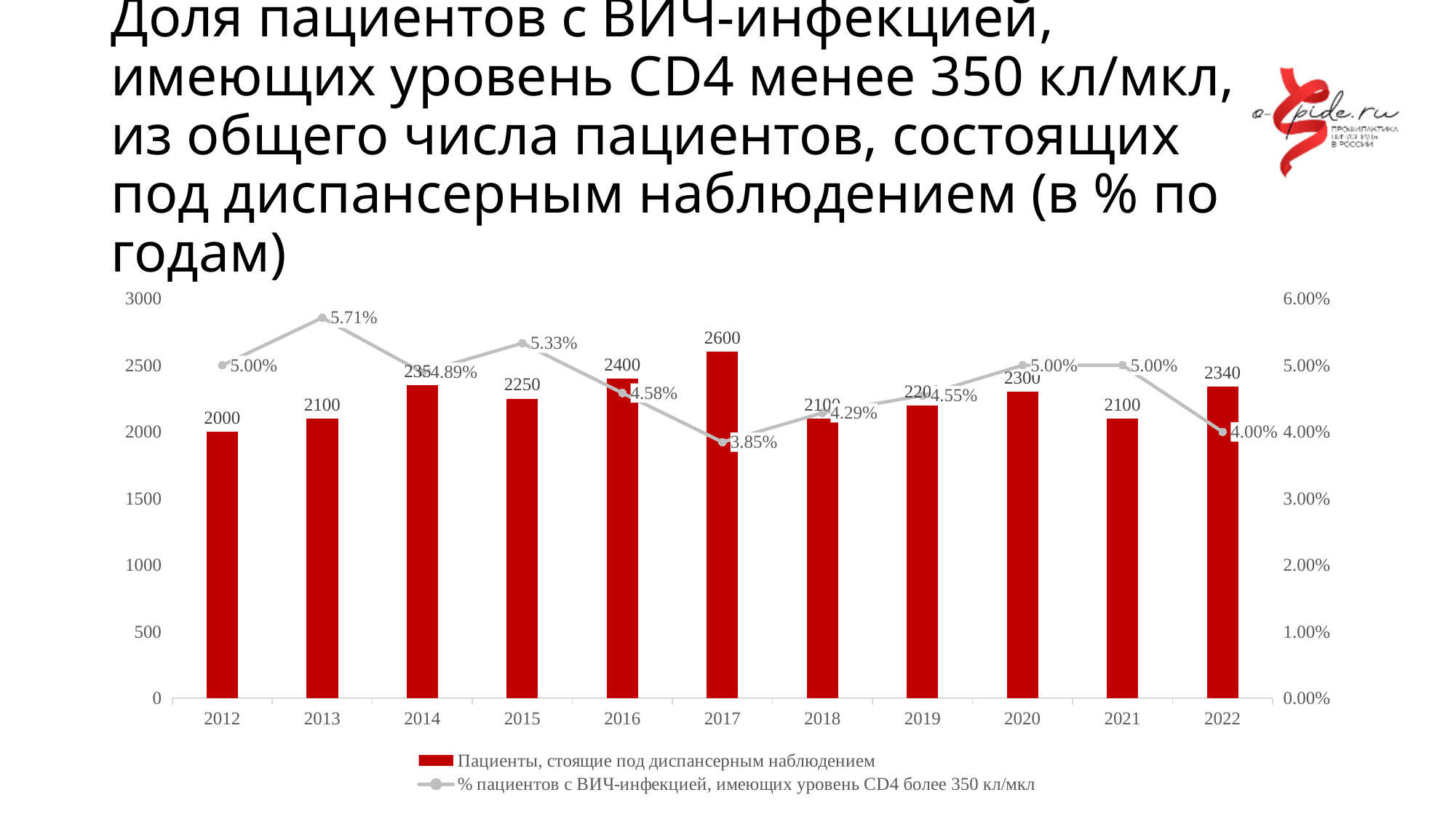
What is the value of the bar for 2017? 2600 Is the bar value for 2018 greater or less than 2500? less What percentage does the line series show for 2013? 5.71% What is the difference between the bar values for 2017 and 2012? 600 What is the value of the bar for 2022? 2340 How many series does the legend list? 2 In which year is the bar for patients under dispensary observation the highest? 2017 In which year is the line series (percentage) at its highest? 2013 In which year is the line series (percentage) at its lowest? 2017 Which year has the larger bar value, 2015 or 2016? 2016 What percentage does the line series show for 2017? 3.85% How many years are shown on the x axis? 11